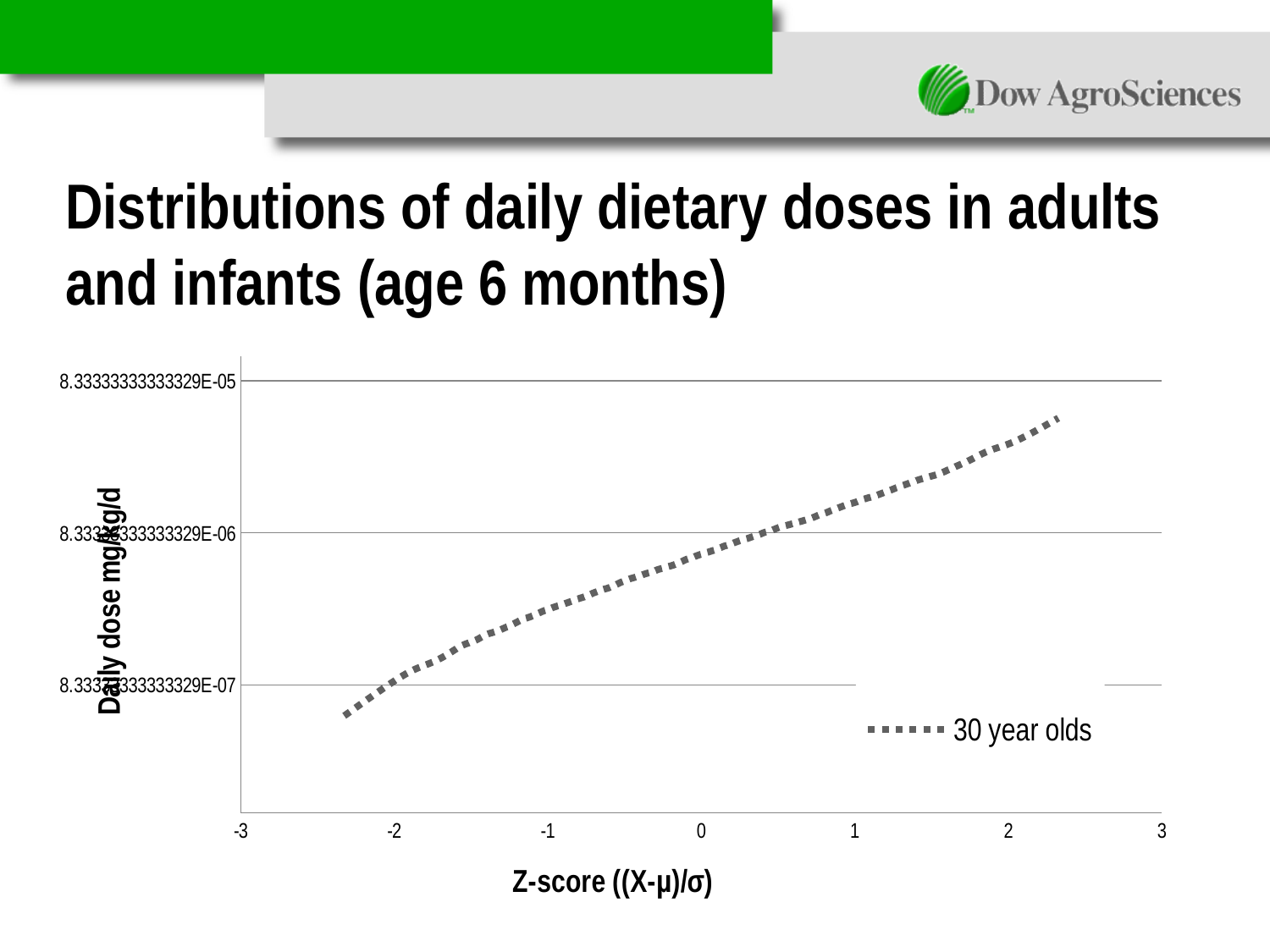
What kind of chart is shown on the slide? line chart What is the title of the x axis of the chart? Z-score ((X-μ)/σ) What series name appears in the chart legend? 30 year olds Does the daily dose for 30 year olds rise or fall as the Z-score increases? rise Is the daily dose for 30 year olds at a Z-score of -1 greater or less than 8.33333333333329E-07? greater How many series does the chart legend list? 1 Is the daily dose for 30 year olds at a Z-score of 2 greater or less than 8.33333333333329E-06? greater Is the daily dose for 30 year olds at a Z-score of -1 greater or less than 8.33333333333329E-06? less What is the lowest Z-score value shown on the x axis of the chart? -3 Which is larger for 30 year olds: the daily dose at a Z-score of 2 or at a Z-score of -2? Z-score of 2